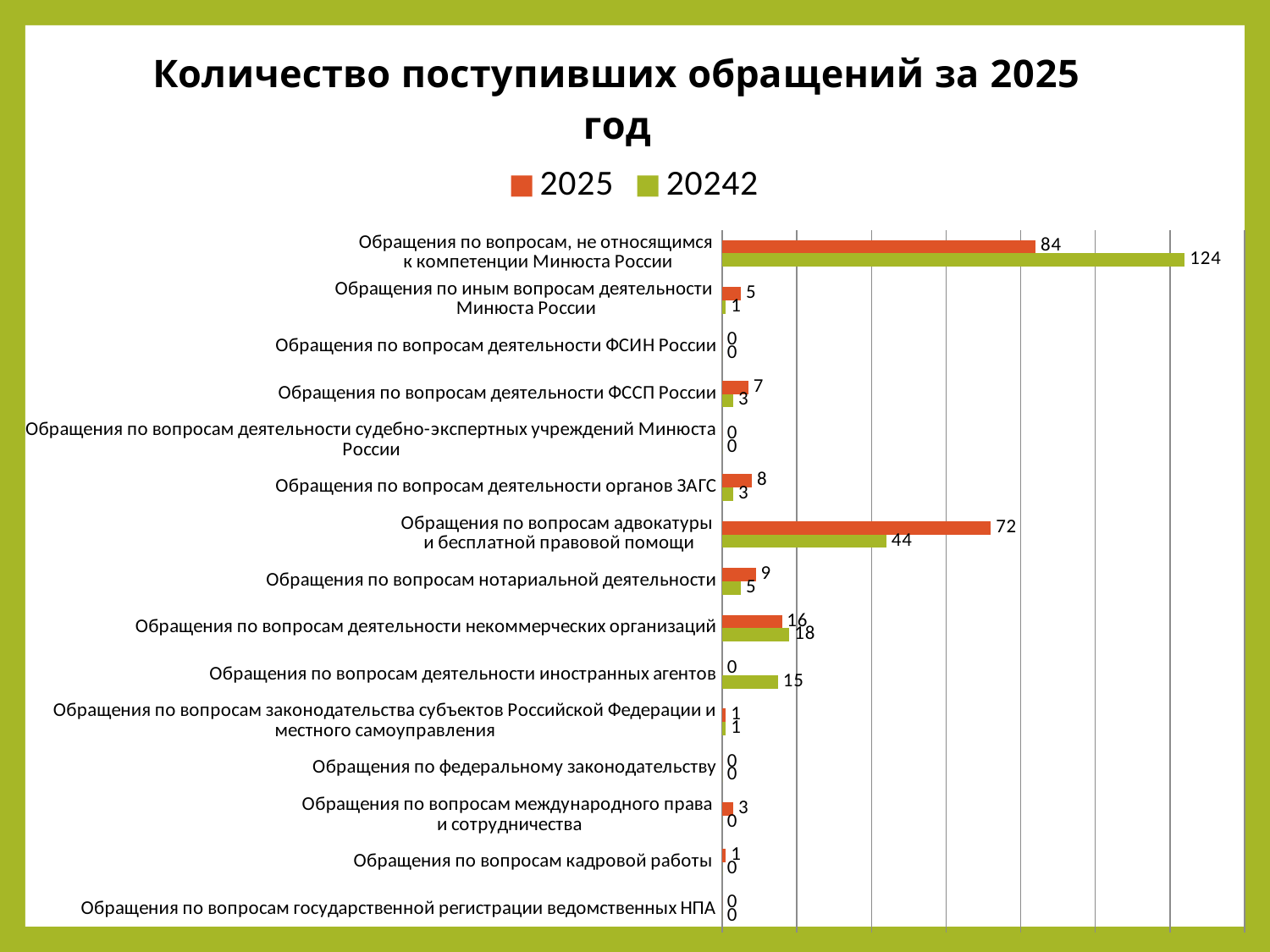
What is the 20242 value for "Обращения по вопросам адвокатуры и бесплатной правовой помощи"? 44 What kind of chart is shown on the slide? Bar chart For "Обращения по вопросам деятельности некоммерческих организаций", which series has the larger value, 2025 or 20242? 20242 What is the 2025 value for "Обращения по вопросам, не относящимся к компетенции Минюста России"? 84 What is the difference between the 2025 and 20242 values for "Обращения по вопросам адвокатуры и бесплатной правовой помощи"? 28 For "Обращения по вопросам деятельности ФССП России", which series has the larger value, 2025 or 20242? 2025 How many series does the legend list? 2 What is the 20242 value for "Обращения по вопросам деятельности иностранных агентов"? 15 Which category has the highest 20242 value? Обращения по вопросам, не относящимся к компетенции Минюста России How many categories are shown on the chart? 15 What is the 2025 value for "Обращения по вопросам деятельности органов ЗАГС"? 8 What is the difference between the 20242 and 2025 values for "Обращения по вопросам, не относящимся к компетенции Минюста России"? 40